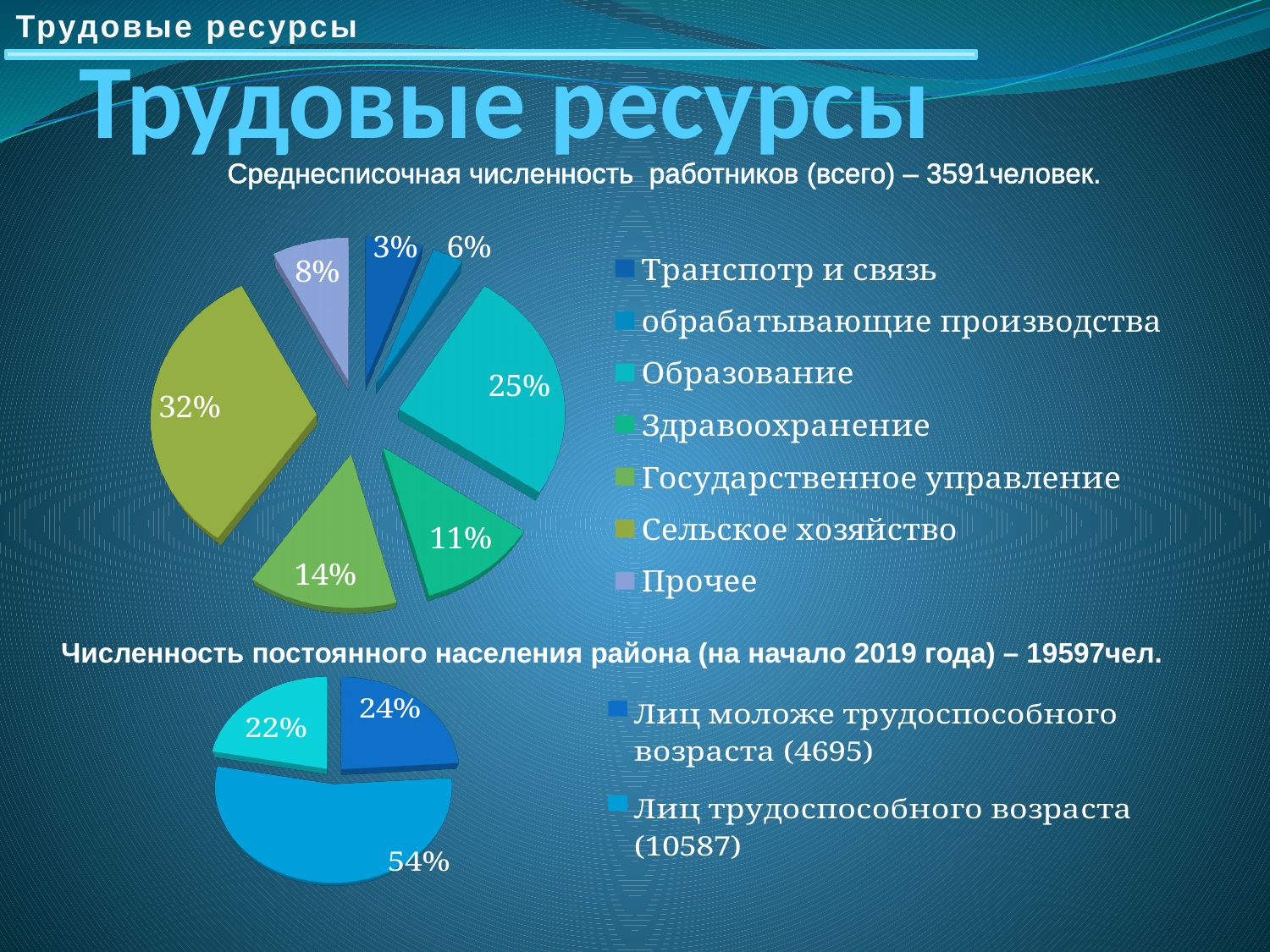
In the top pie chart, what share is labelled for Здравоохранение? 11% In the top pie chart, which category has the largest slice? Сельское хозяйство In the top pie chart, how many categories does the legend list? 7 In the top pie chart, what is the difference between the shares of Сельское хозяйство and Образование? 7% In the top pie chart, which category has the smallest slice? обрабатывающие производства In the top pie chart, what share is labelled for Образование? 25% In the bottom pie chart, what share is labelled for Лиц трудоспособного возраста? 54% In the bottom pie chart, how many entries does the legend list? 2 In the top pie chart, which is larger: the share of Прочее or the share of обрабатывающие производства? Прочее What kind of chart is the bottom chart (Численность постоянного населения района)? Pie chart